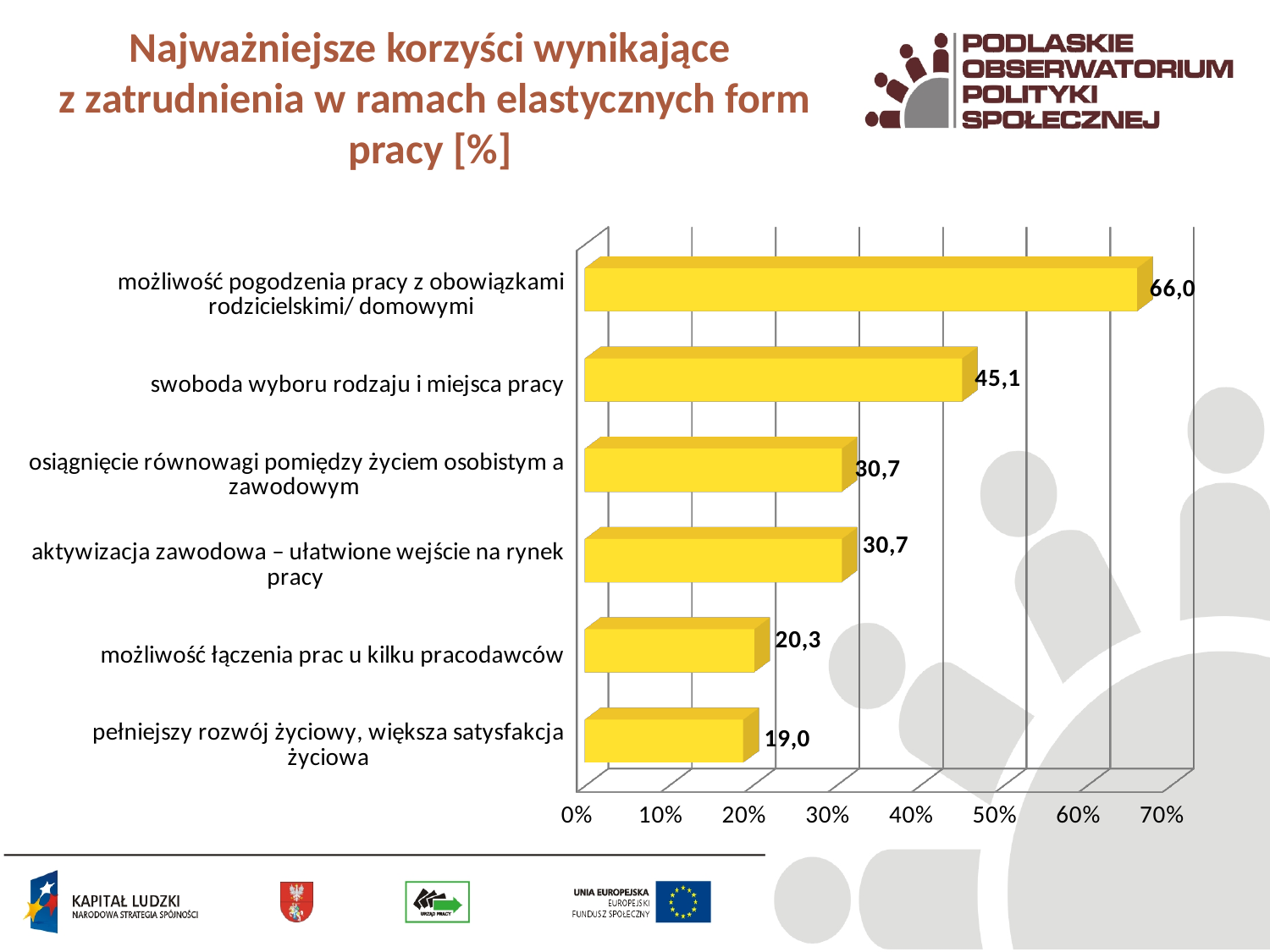
Which is larger: the value for "swoboda wyboru rodzaju i miejsca pracy" or for "aktywizacja zawodowa – ułatwione wejście na rynek pracy"? swoboda wyboru rodzaju i miejsca pracy What is the value for "pełniejszy rozwój życiowy, większa satysfakcja życiowa"? 19,0 What is the value for "możliwość łączenia prac u kilku pracodawców"? 20,3 What is the value for "możliwość pogodzenia pracy z obowiązkami rodzicielskimi/ domowymi"? 66,0 What kind of chart is shown on the slide? bar chart Which category has the lowest value? pełniejszy rozwój życiowy, większa satysfakcja życiowa Is the value for "osiągnięcie równowagi pomiędzy życiem osobistym a zawodowym" greater or less than 40%? less How many categories are shown in the chart? 6 What is the difference between the values for "możliwość pogodzenia pracy z obowiązkami rodzicielskimi/ domowymi" and "swoboda wyboru rodzaju i miejsca pracy"? 20,9 What is the title of the chart on the slide? Najważniejsze korzyści wynikające z zatrudnienia w ramach elastycznych form pracy [%] What is the value for "swoboda wyboru rodzaju i miejsca pracy"? 45,1 Which category has the highest value? możliwość pogodzenia pracy z obowiązkami rodzicielskimi/ domowymi